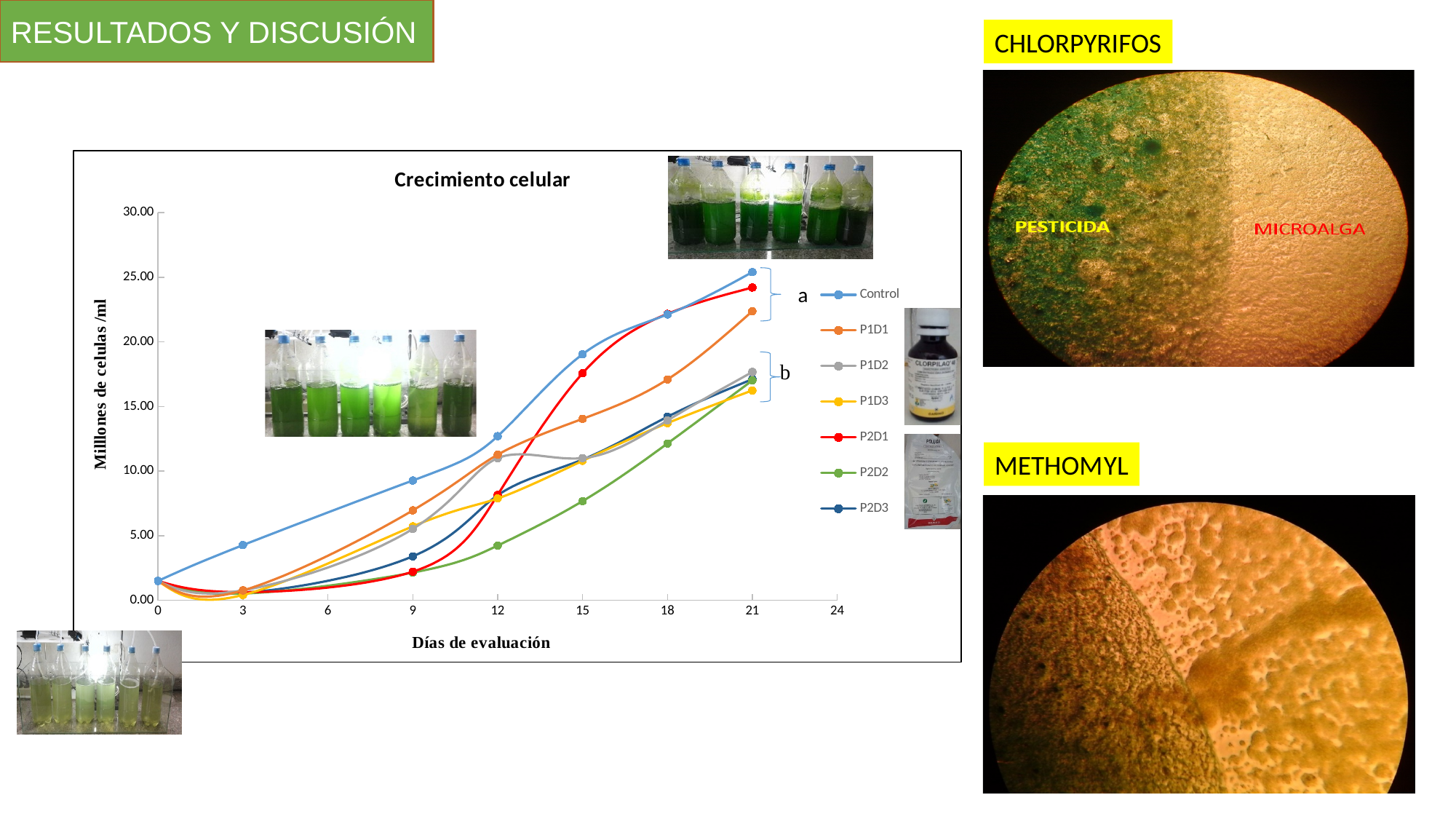
Which series has the highest value at day 9 in the 'Crecimiento celular' chart? Control What is the title of the chart on the slide? Crecimiento celular Which series has the highest value at day 21 in the 'Crecimiento celular' chart? Control What type of chart is 'Crecimiento celular'? line chart Which series has the lowest value at day 15 in the 'Crecimiento celular' chart? P2D2 How many series does the legend of the 'Crecimiento celular' chart list? 7 Is the value for P1D1 at day 21 greater or less than 20.00? greater Is the value for Control at day 15 greater or less than 15.00? greater Does the Control series rise or fall as the days of evaluation increase? rise Is the value for P2D2 at day 15 greater or less than 10.00? less What is the x-axis label of the 'Crecimiento celular' chart? Días de evaluación At day 18, which is larger: P1D1 or P2D2? P1D1